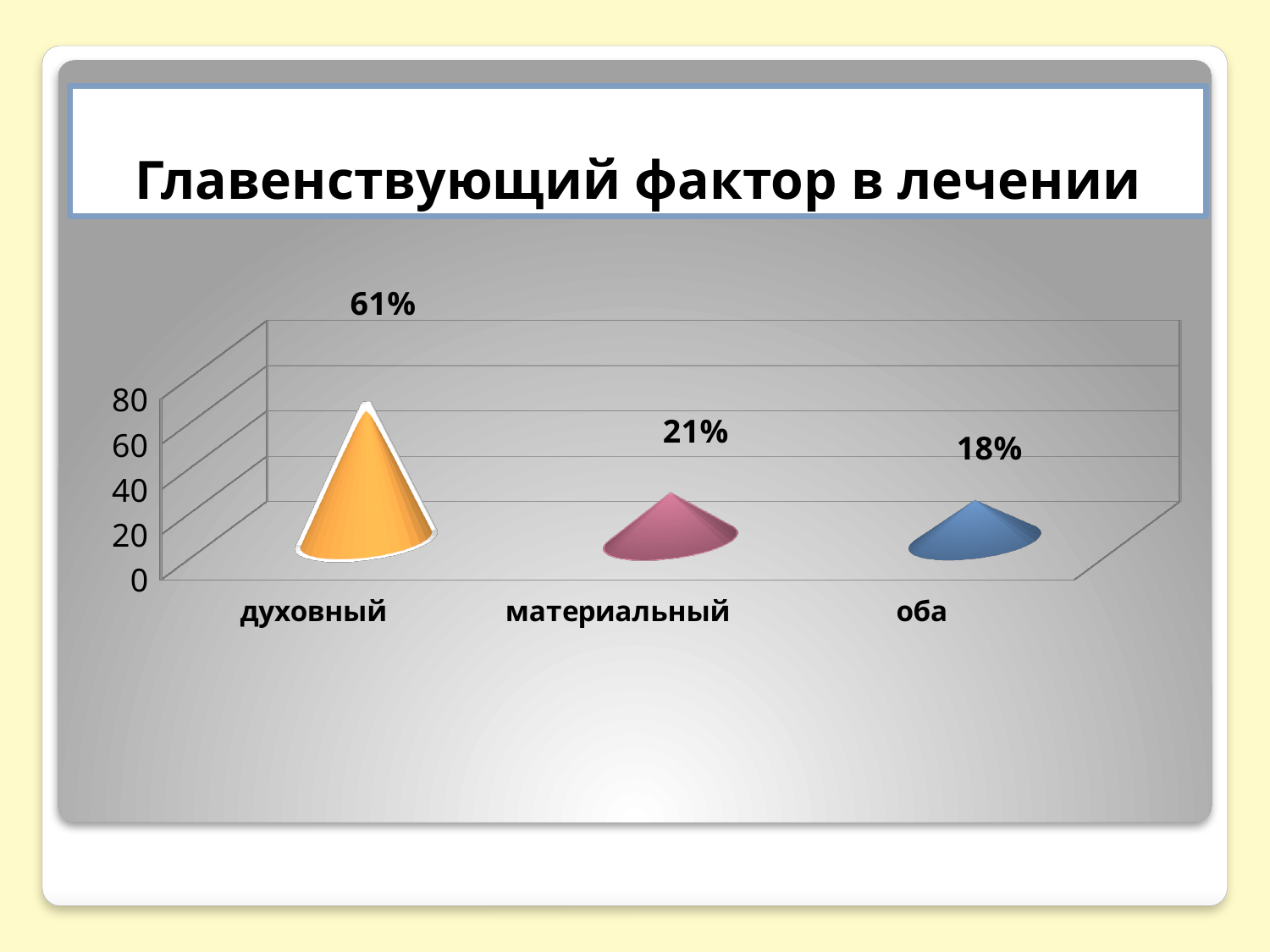
What kind of chart is shown on the slide? bar chart Which category has the highest value? духовный Which is larger, the value for материальный or the value for оба? материальный How many categories are shown on the x axis? 3 Is the value for духовный greater or less than 40? greater What is the value for оба? 18% Which category has the lowest value? оба What is the value for материальный? 21% What is the title of the chart? Главенствующий фактор в лечении What is the value for духовный? 61% What is the difference between the values for духовный and материальный? 40% What is the difference between the values for материальный and оба? 3%